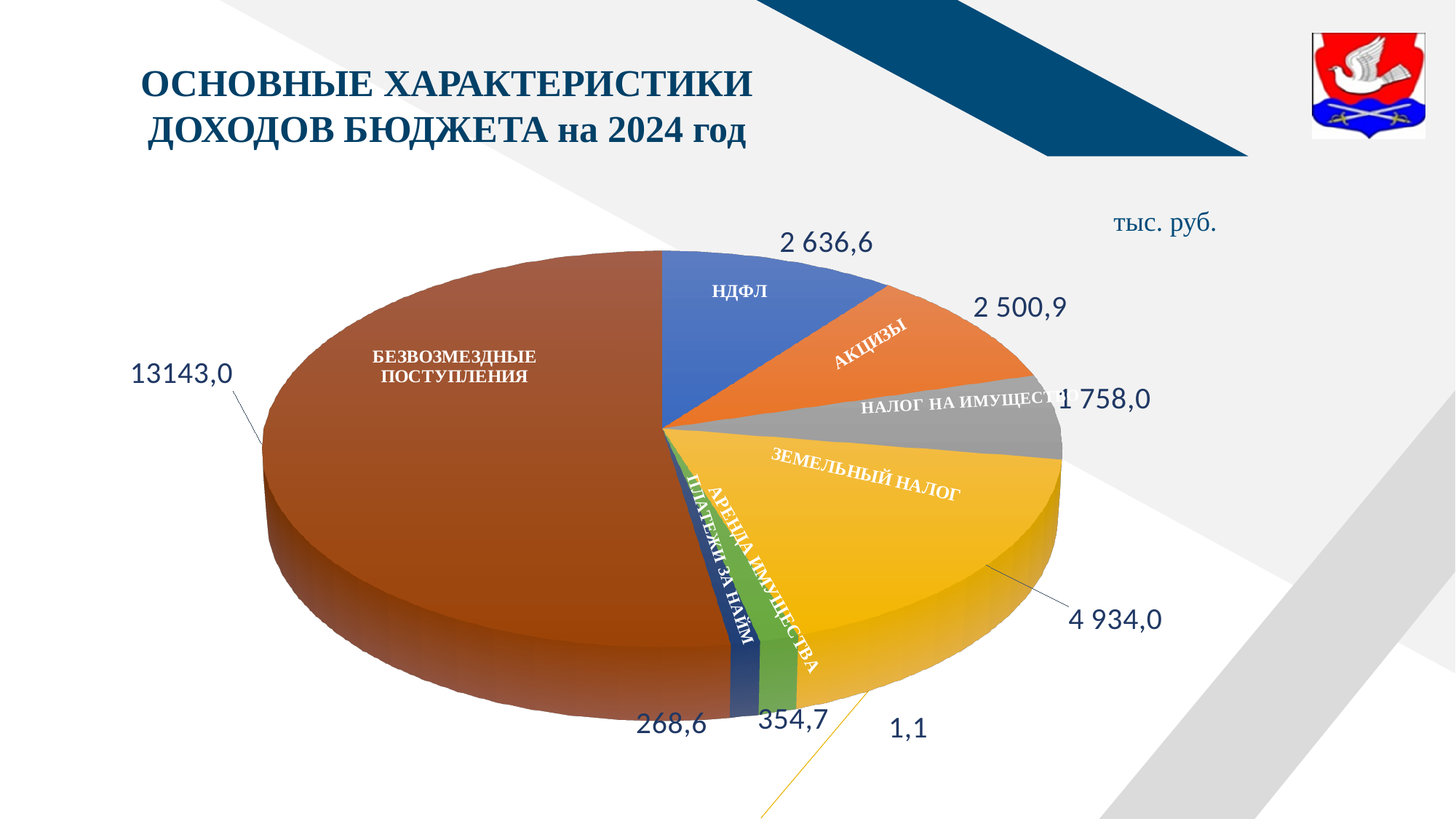
What is the value for АРЕНДА ИМУЩЕСТВА? 354,7 What is the value for НДФЛ? 2 636,6 In what units are the values on the chart given? тыс. руб. What is the value for ПЛАТЕЖИ ЗА НАЙМ? 268,6 What kind of chart is shown on the slide? pie chart What is the value for АКЦИЗЫ? 2 500,9 What is the value for ЗЕМЕЛЬНЫЙ НАЛОГ? 4 934,0 What is the difference between ЗЕМЕЛЬНЫЙ НАЛОГ and НАЛОГ НА ИМУЩЕСТВО? 3 176,0 Which is larger, НДФЛ or АКЦИЗЫ? НДФЛ What is the value for БЕЗВОЗМЕЗДНЫЕ ПОСТУПЛЕНИЯ? 13143,0 Which category has the largest slice of the pie? БЕЗВОЗМЕЗДНЫЕ ПОСТУПЛЕНИЯ What is the value for НАЛОГ НА ИМУЩЕСТВО? 1 758,0